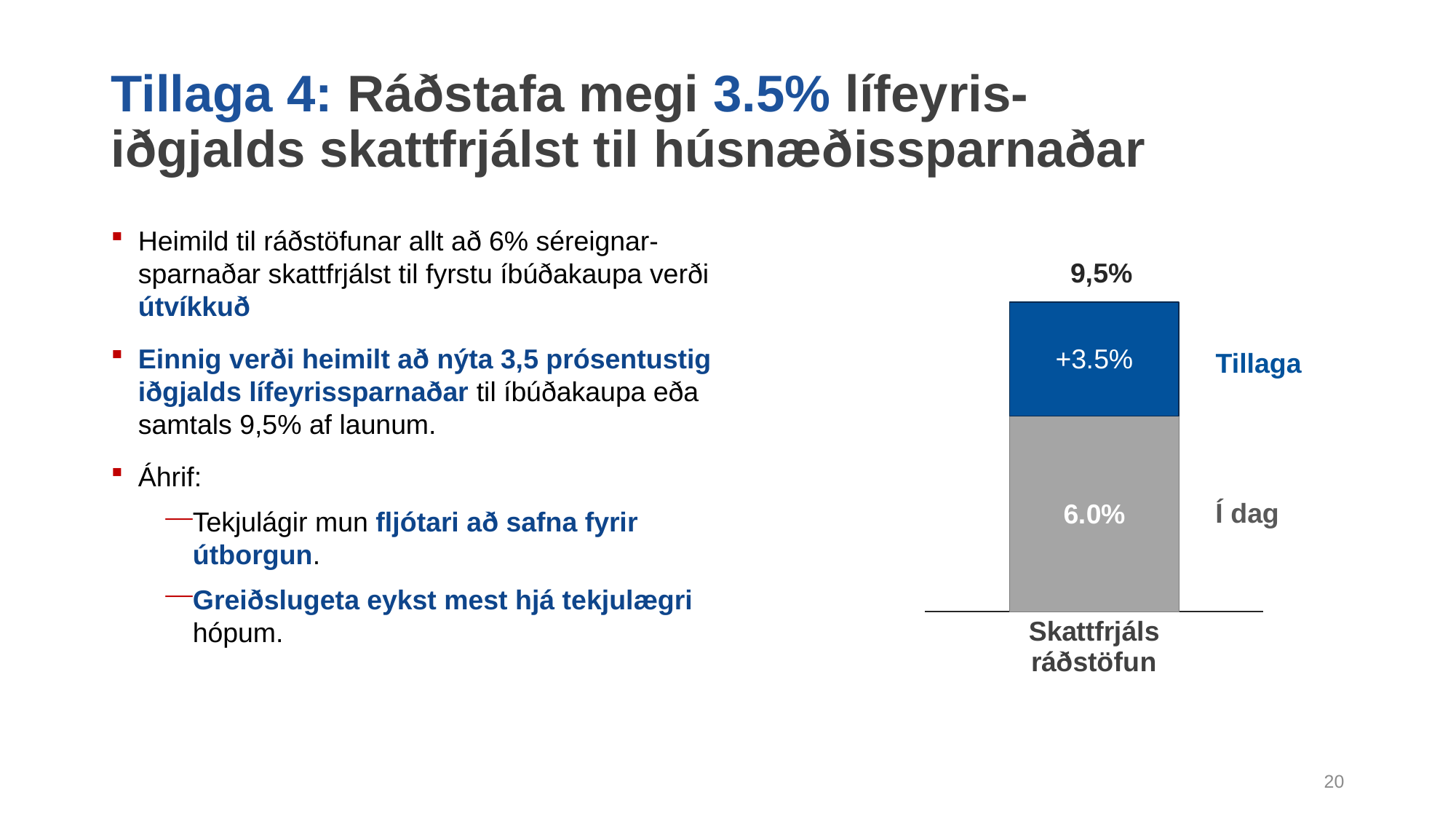
Which segment of the bar is coloured blue? Tillaga Which segment of the bar is larger, "Í dag" or "Tillaga"? Í dag What is the value of the "Tillaga" segment of the stacked bar? +3.5% What is the value of the "Í dag" segment of the stacked bar? 6.0% Which segment is the largest in the stacked bar? Í dag Which segment is the smallest in the stacked bar? Tillaga How many segments (series) make up the stacked bar? 2 What kind of chart is shown on the slide? Stacked bar chart How many categories are plotted on the x axis of the chart? 1 What is the total shown at the top of the stacked bar? 9,5% What is the category label under the bar? Skattfrjáls ráðstöfun What is the difference between the "Í dag" segment and the "Tillaga" segment? 2.5%